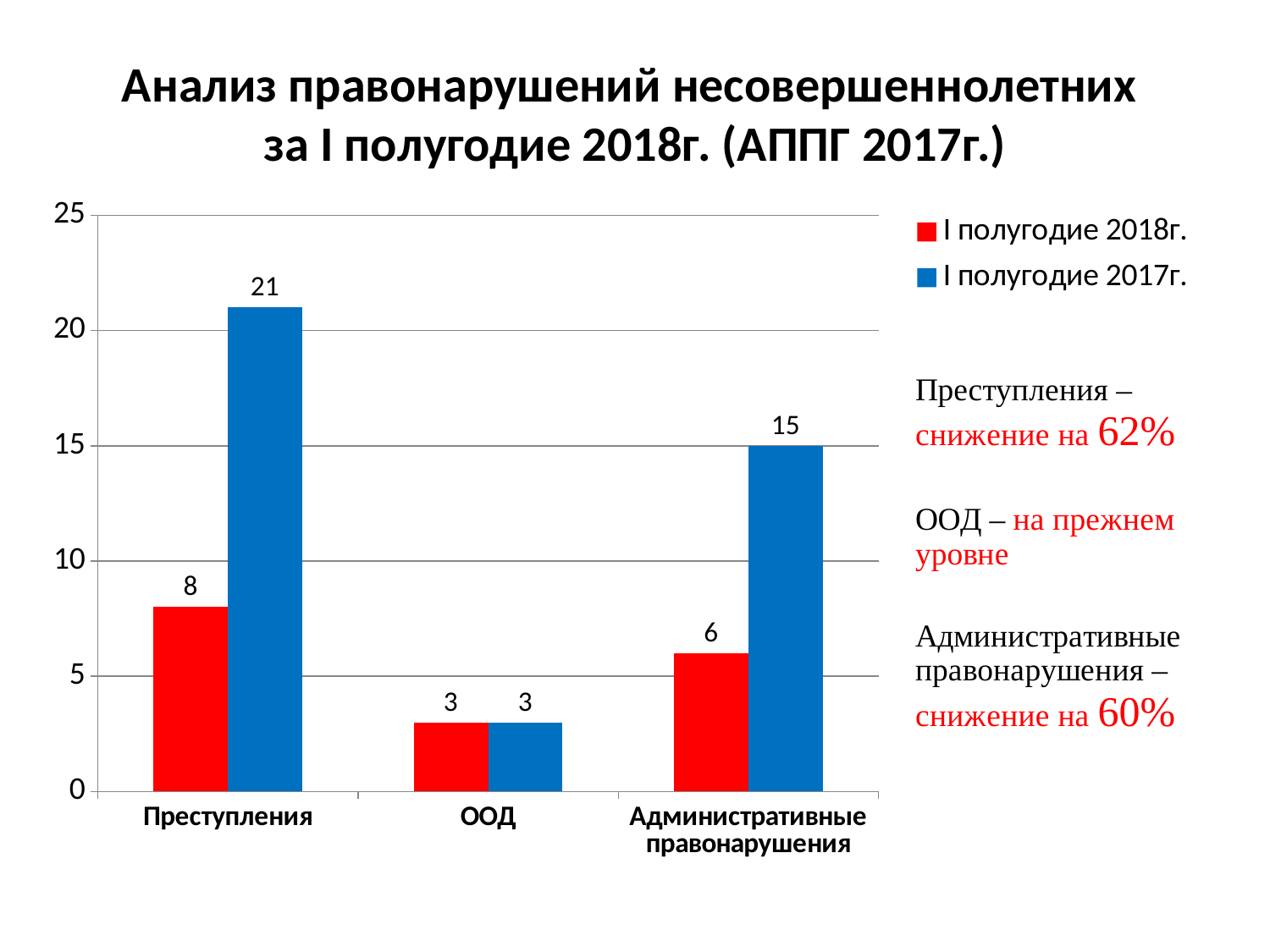
Which category has the highest value in I полугодие 2017г.? Преступления What is the value for Преступления in I полугодие 2017г.? 21 Which category has the lowest value in I полугодие 2018г.? ООД How many series does the legend list? 2 What is the difference between the I полугодие 2017г. and I полугодие 2018г. values for Преступления? 13 What kind of chart is shown on the slide? Bar chart How many categories are shown on the x axis? 3 What is the value for Административные правонарушения in I полугодие 2017г.? 15 What is the value for ООД in I полугодие 2018г.? 3 What is the difference between the I полугодие 2017г. and I полугодие 2018г. values for Административные правонарушения? 9 Which is larger for Административные правонарушения: the I полугодие 2018г. value or the I полугодие 2017г. value? I полугодие 2017г. What is the value for Преступления in I полугодие 2018г.? 8